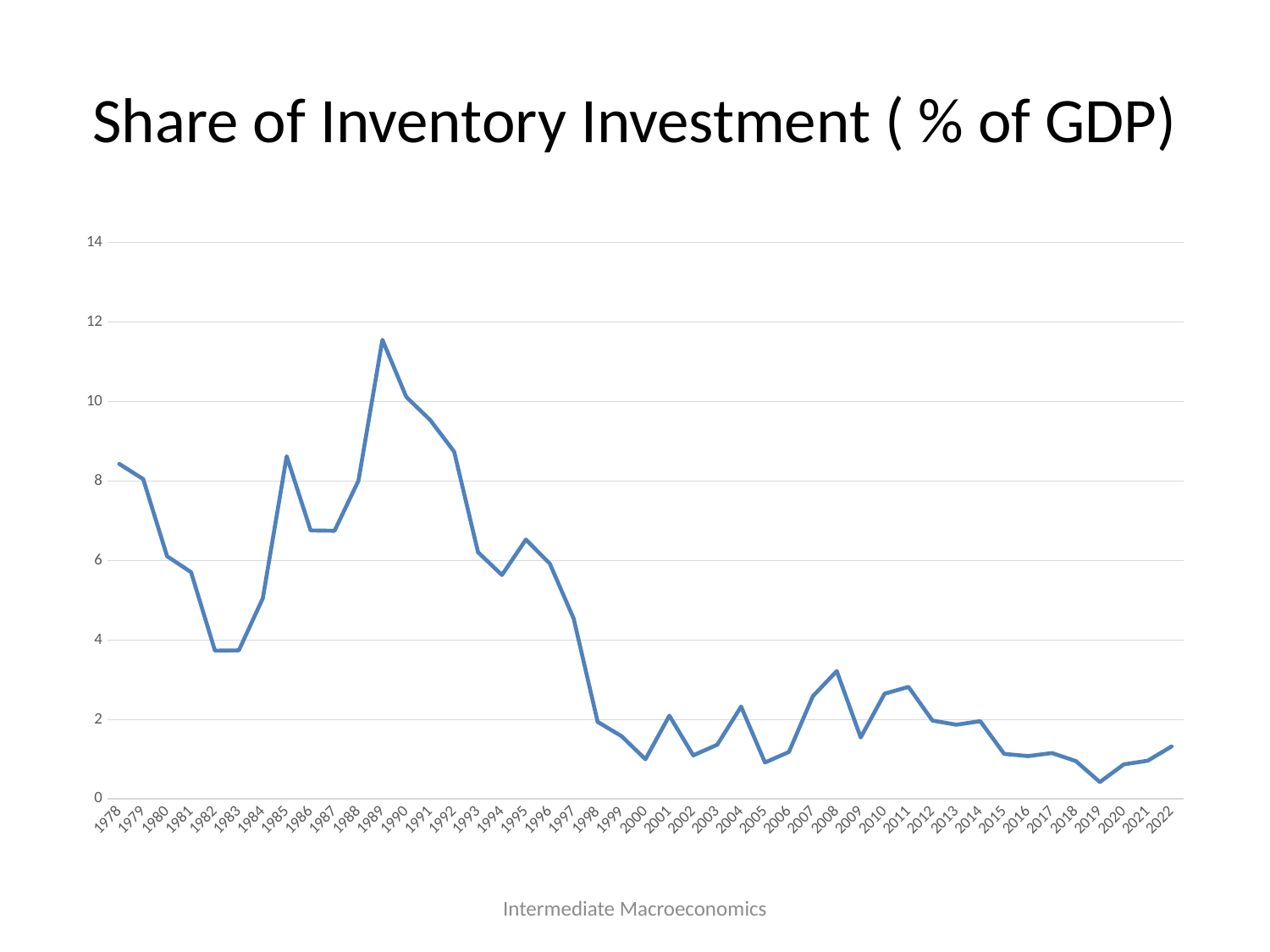
What kind of chart is shown on the slide? line chart Is the value for 1985 greater or less than 8? greater What is the title of the chart? Share of Inventory Investment ( % of GDP) Is the value for 2019 greater or less than 2? less How many years are plotted along the x axis? 45 Is the value for 1989 greater or less than 10? greater Which year has the larger value, 1982 or 1985? 1985 In which year does the share of inventory investment reach its highest value? 1989 Which year has the larger value, 1989 or 2008? 1989 Overall, does the share of inventory investment rise or fall from 1978 to 2022? fall In which year does the share of inventory investment reach its lowest value? 2019